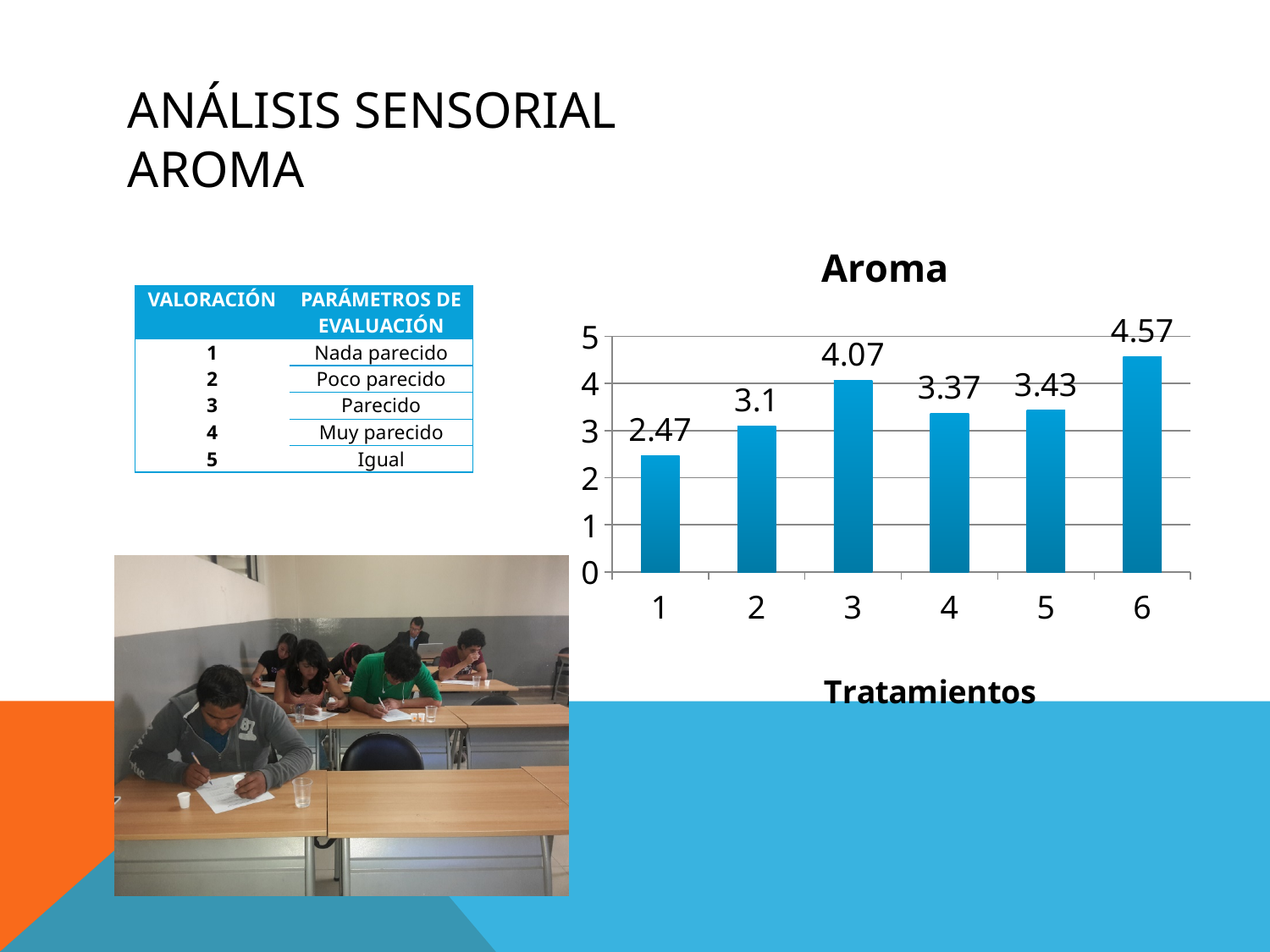
Is the value for treatment 6 in the Aroma chart greater or less than 4? greater How many treatments are shown on the x axis of the Aroma chart? 6 Which has a larger value in the Aroma chart, treatment 2 or treatment 4? Treatment 4 What is the difference between the values for treatment 3 and treatment 2 in the Aroma chart? 0.97 What is the x-axis label of the Aroma chart? Tratamientos Which treatment has the highest value in the Aroma chart? 6 Which treatment has the lowest value in the Aroma chart? 1 What is the difference between the values for treatment 6 and treatment 1 in the Aroma chart? 2.1 What kind of chart is the Aroma chart? Bar chart What is the value for treatment 1 in the Aroma chart? 2.47 What is the value for treatment 5 in the Aroma chart? 3.43 What is the value for treatment 3 in the Aroma chart? 4.07